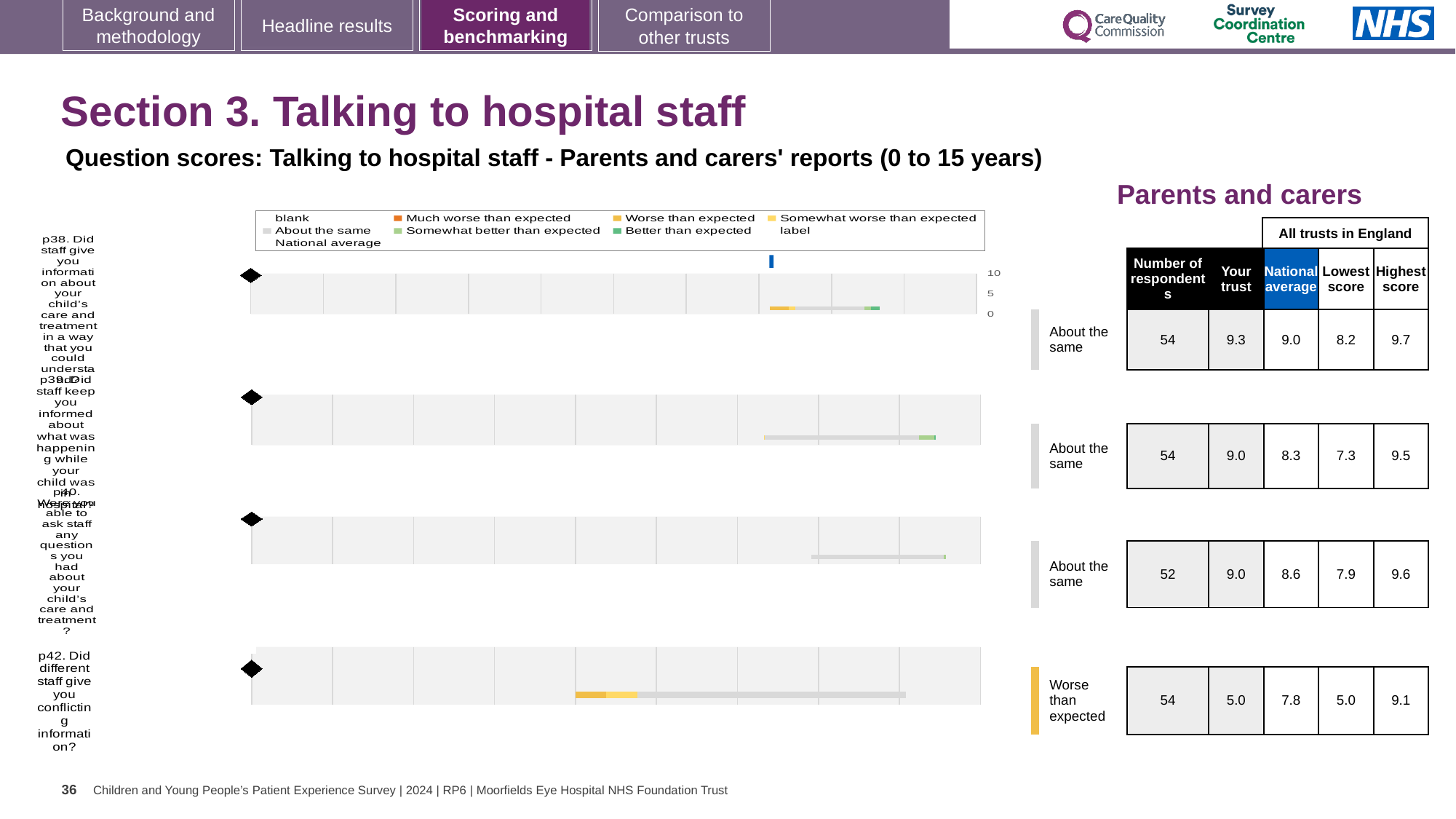
In the legend, which colour represents 'Better than expected'? green For the p42 chart, what benchmark category label is shown next to it? Worse than expected What kind of chart is used for each question (p38, p39, p40, p42) on this slide? bar chart For the p38 chart, what national average score is shown in the accompanying table? 9.0 How many separate question charts are shown on the slide? 4 In the legend, which colour represents 'Much worse than expected'? orange For the p42 chart (conflicting information), what 'Your trust' score is shown in the accompanying table? 5.0 What is the highest tick value shown on the axis of the p38 chart? 10 For the p39 chart, what is the difference between the highest score (9.5) and the lowest score (7.3) shown in the table? 2.2 How many entries does the legend above the charts list? 9 Which question chart has the lowest 'Your trust' score according to the table: p38, p39, p40 or p42? p42 For the p40 chart, is the 'Your trust' score (9.0) larger or smaller than the national average (8.6)? larger